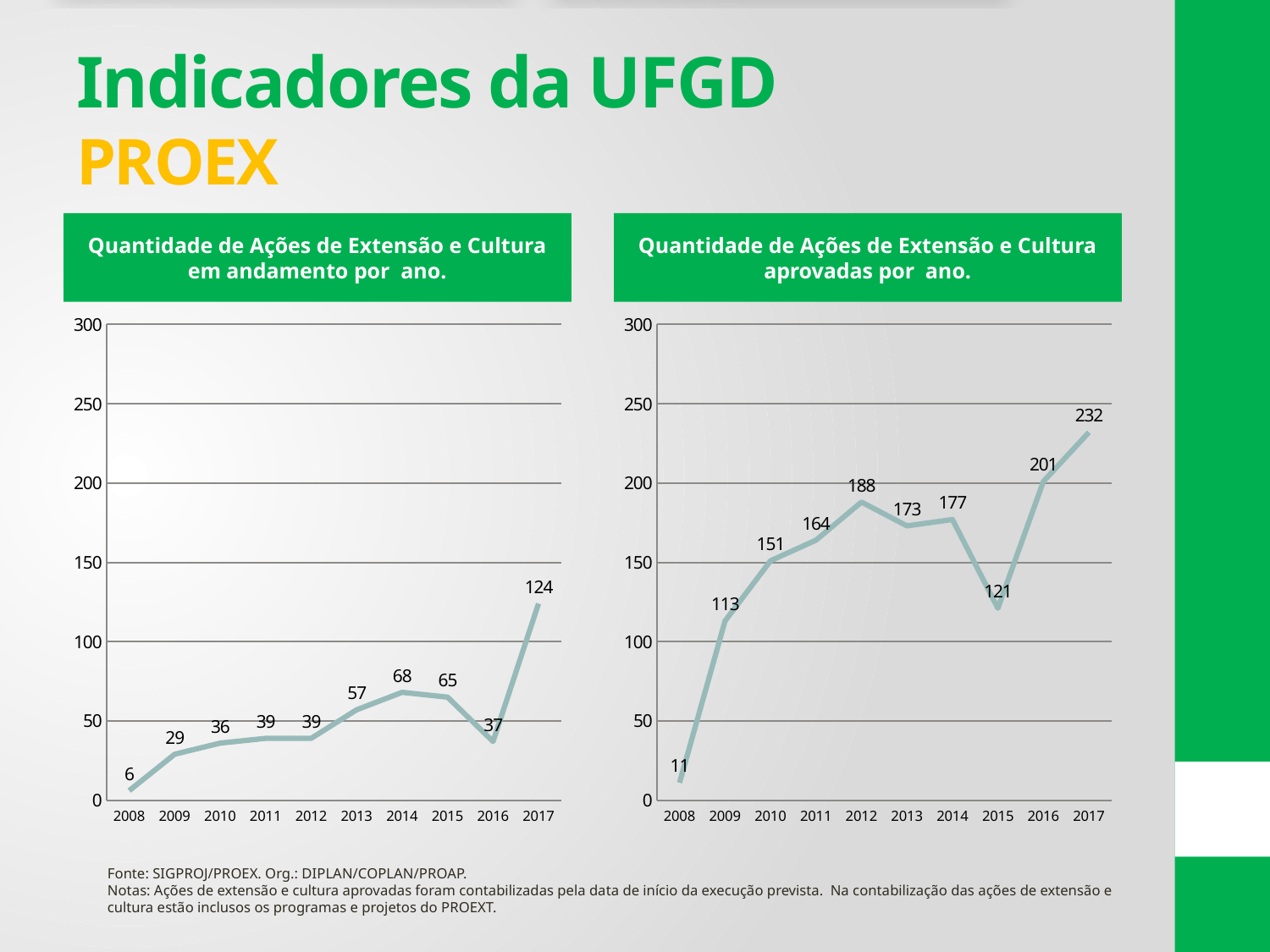
What kind of chart is 'Quantidade de Ações de Extensão e Cultura aprovadas por ano'? line chart In the chart 'Quantidade de Ações de Extensão e Cultura aprovadas por ano', what is the value for 2012? 188 In the chart 'Quantidade de Ações de Extensão e Cultura em andamento por ano', what is the value for 2008? 6 In the chart 'Quantidade de Ações de Extensão e Cultura aprovadas por ano', what is the difference between the values for 2017 and 2016? 31 In the chart 'Quantidade de Ações de Extensão e Cultura aprovadas por ano', which is larger, the value for 2013 or the value for 2014? 2014 In the chart 'Quantidade de Ações de Extensão e Cultura em andamento por ano', which year has the lowest value? 2008 How many years are plotted in the chart 'Quantidade de Ações de Extensão e Cultura em andamento por ano'? 10 In the chart 'Quantidade de Ações de Extensão e Cultura aprovadas por ano', which year has the highest value? 2017 In the chart 'Quantidade de Ações de Extensão e Cultura aprovadas por ano', is the value for 2015 greater or less than 150? less In the chart 'Quantidade de Ações de Extensão e Cultura em andamento por ano', does the value rise or fall from 2015 to 2016? fall In the chart 'Quantidade de Ações de Extensão e Cultura em andamento por ano', what is the value for 2017? 124 In the chart 'Quantidade de Ações de Extensão e Cultura em andamento por ano', what is the difference between the values for 2014 and 2016? 31